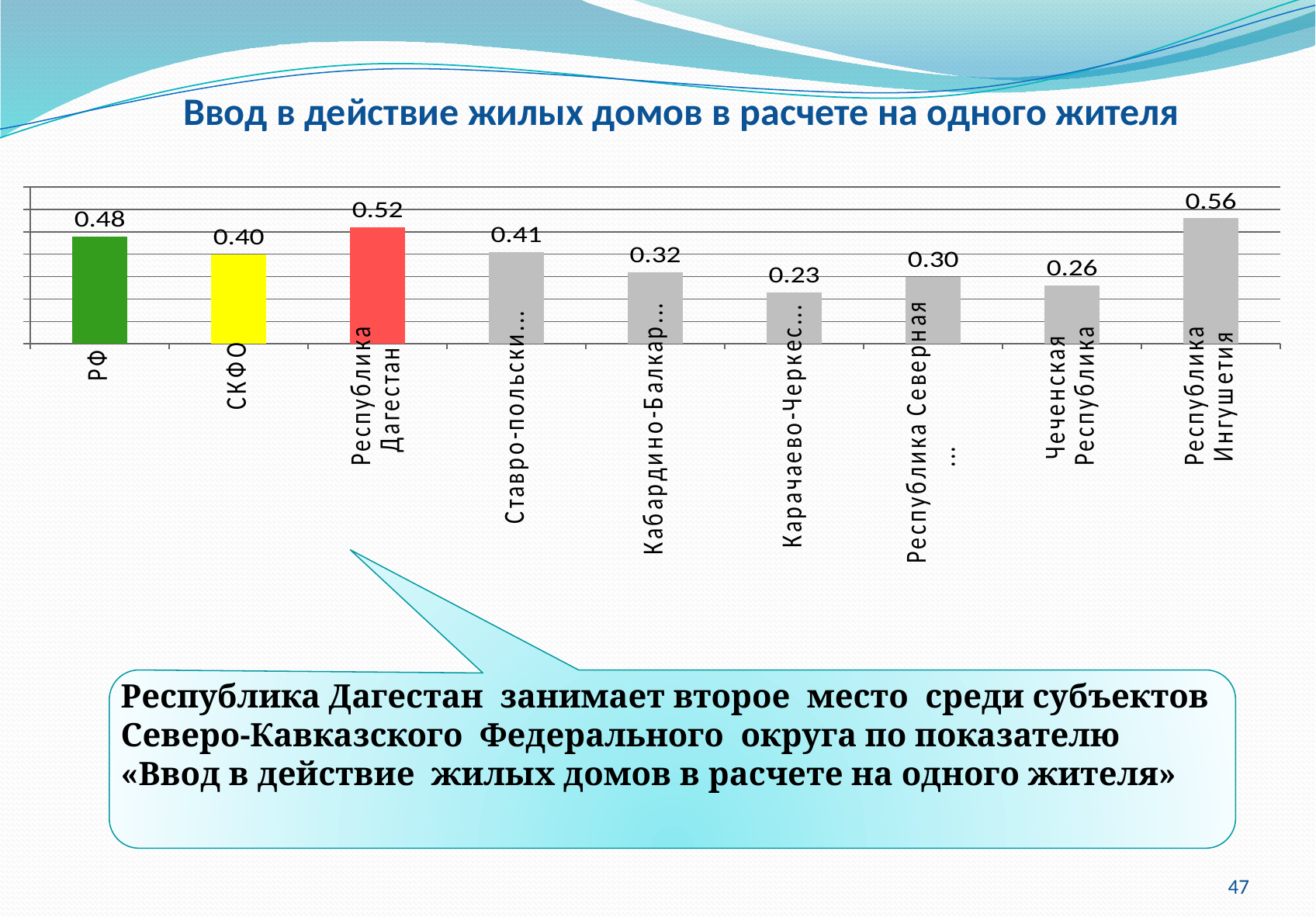
What is the difference between the values for Республика Ингушетия and Республика Дагестан? 0.04 Which category has the lowest value? Карачаево-Черкес... What is the value for СКФО? 0.40 Which is larger, the value for Республика Дагестан or the value for РФ? Республика Дагестан What is the value for РФ? 0.48 What kind of chart is shown on the slide? bar chart Which category has the highest value? Республика Ингушетия What is the value for Чеченская Республика? 0.26 What is the value for Республика Ингушетия? 0.56 What is the value for Республика Дагестан? 0.52 How many bars are shown in the chart? 9 What colour is the bar for Республика Дагестан? red